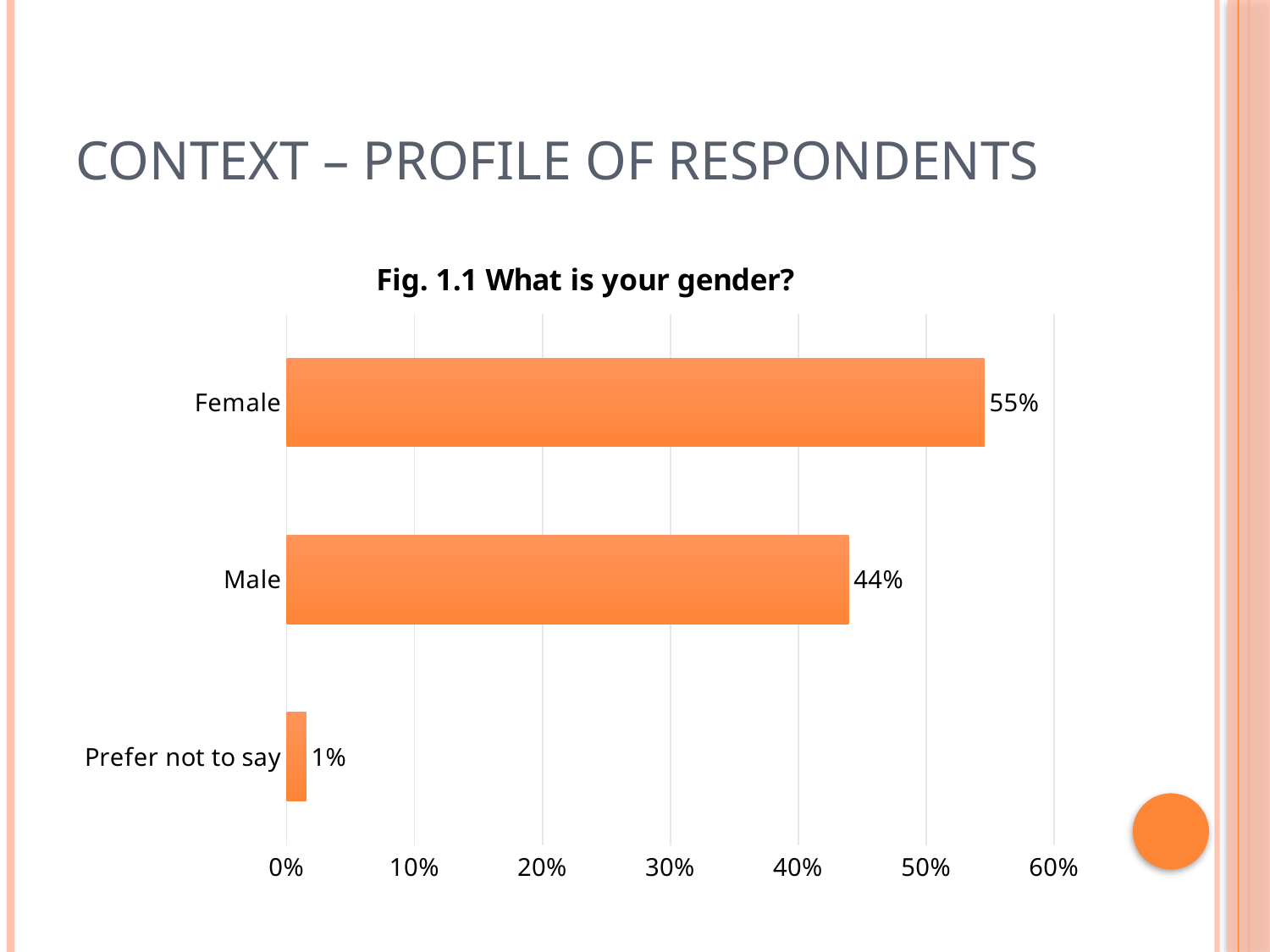
Which gender category has the highest percentage of respondents? Female What kind of chart is shown on the slide? Bar chart How many gender categories are shown in the chart? 3 What is the difference in percentage points between Female and Male respondents? 11% Is the value for Female greater or less than 50%? greater What is the title of the chart? Fig. 1.1 What is your gender? Which gender category has the lowest percentage of respondents? Prefer not to say What is the highest value shown on the x axis of the chart? 60% What percentage of respondents are Male? 44% What percentage of respondents are Female? 55% What percentage of respondents chose 'Prefer not to say'? 1% Which is larger, the percentage of Male respondents or the percentage who prefer not to say? Male